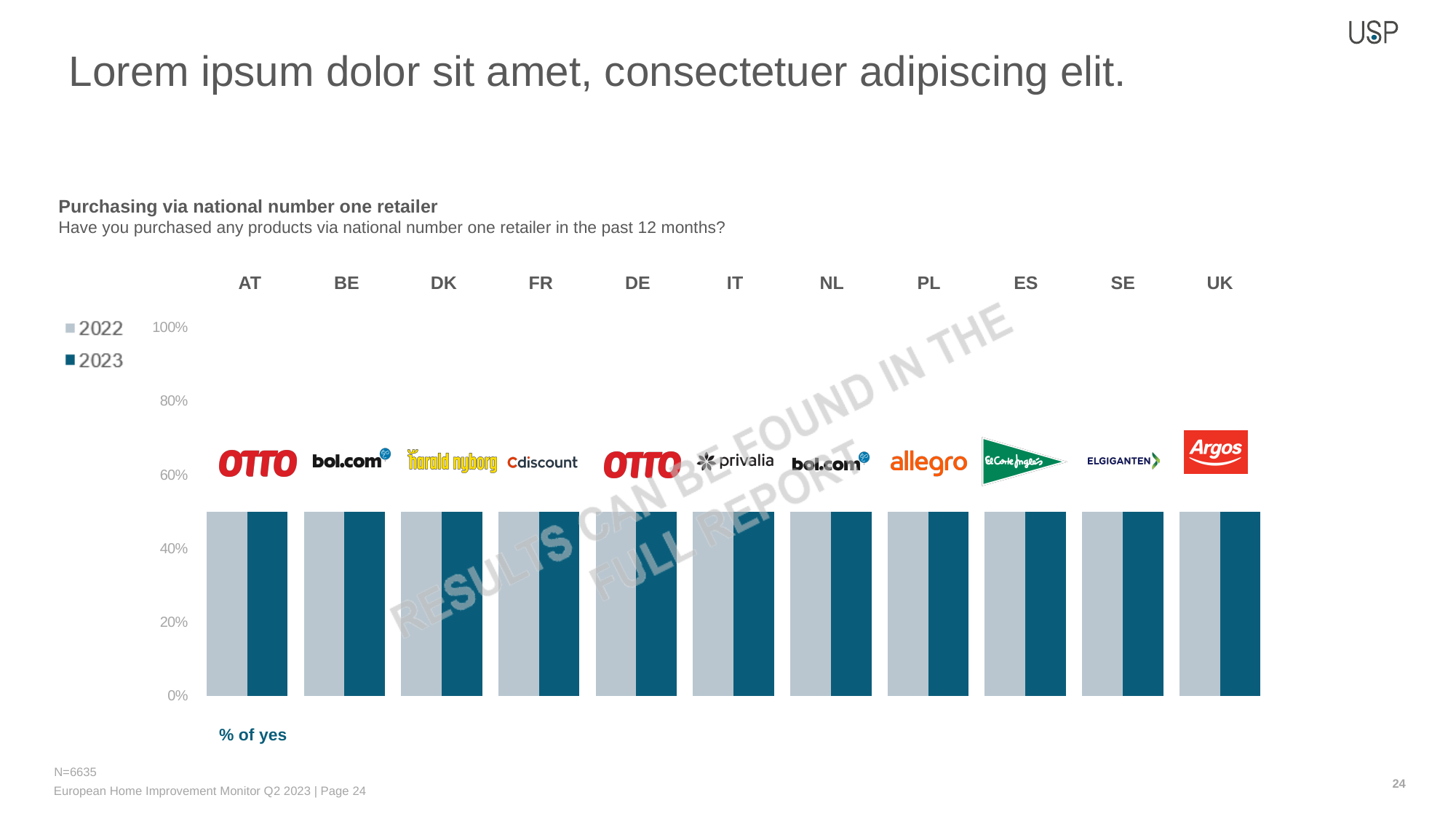
Which years are listed in the chart legend? 2022 and 2023 What is the title of the chart? Purchasing via national number one retailer Is the 2023 value for AT greater or less than 40%? greater Is the 2023 value for PL greater or less than 20%? greater Do the bar values rise, fall, or stay flat across the countries from AT to UK? stay flat How many countries are shown along the x axis of the chart? 11 How many series does the chart legend list? 2 What kind of chart is shown on the slide? bar chart Is the 2022 value for UK greater or less than 60%? less What is the highest value shown on the chart's y axis? 100%